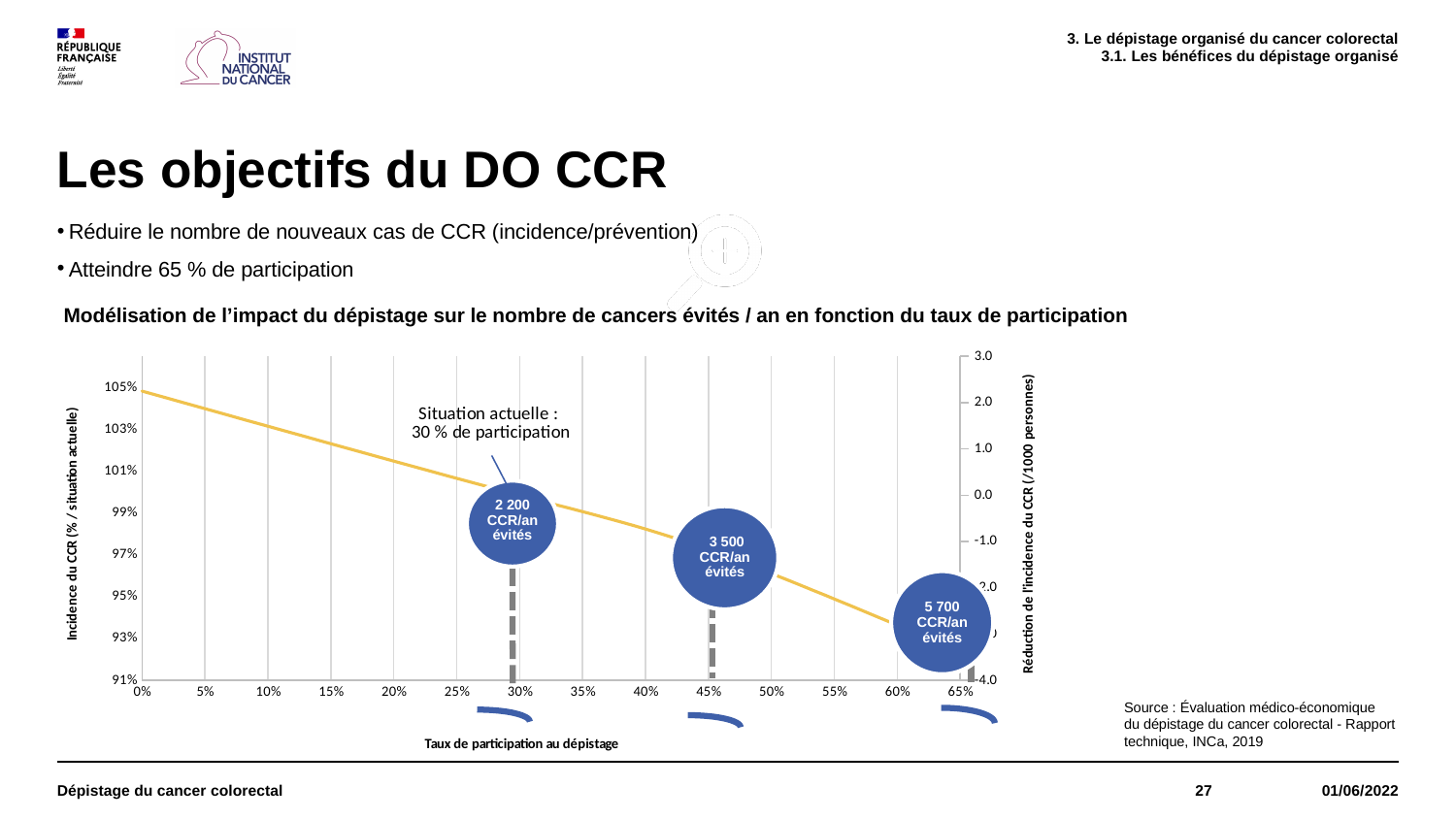
How many cancers avoided per year are indicated at a 45% participation rate? 3 500 CCR/an évités How many labelled bubbles showing cancers avoided per year are on the chart? 3 Which participation rate is labelled as the current situation ("Situation actuelle")? 30 % de participation Is the incidence of CCR at 0% participation greater or less than 103%? greater Which is larger: the number of cancers avoided per year at 65% participation or at 30% participation? 65% participation How many cancers avoided per year are indicated at a 65% participation rate? 5 700 CCR/an évités What kind of chart is shown on the slide? line chart Does the incidence of CCR rise or fall as the participation rate increases along the x axis? fall What is the difference between the cancers avoided per year at 65% participation and at 30% participation? 3 500 How many cancers avoided per year are indicated at a 30% participation rate? 2 200 CCR/an évités What is the difference between the cancers avoided per year at 45% participation and at 30% participation? 1 300 What is the title of the x axis of the chart? Taux de participation au dépistage